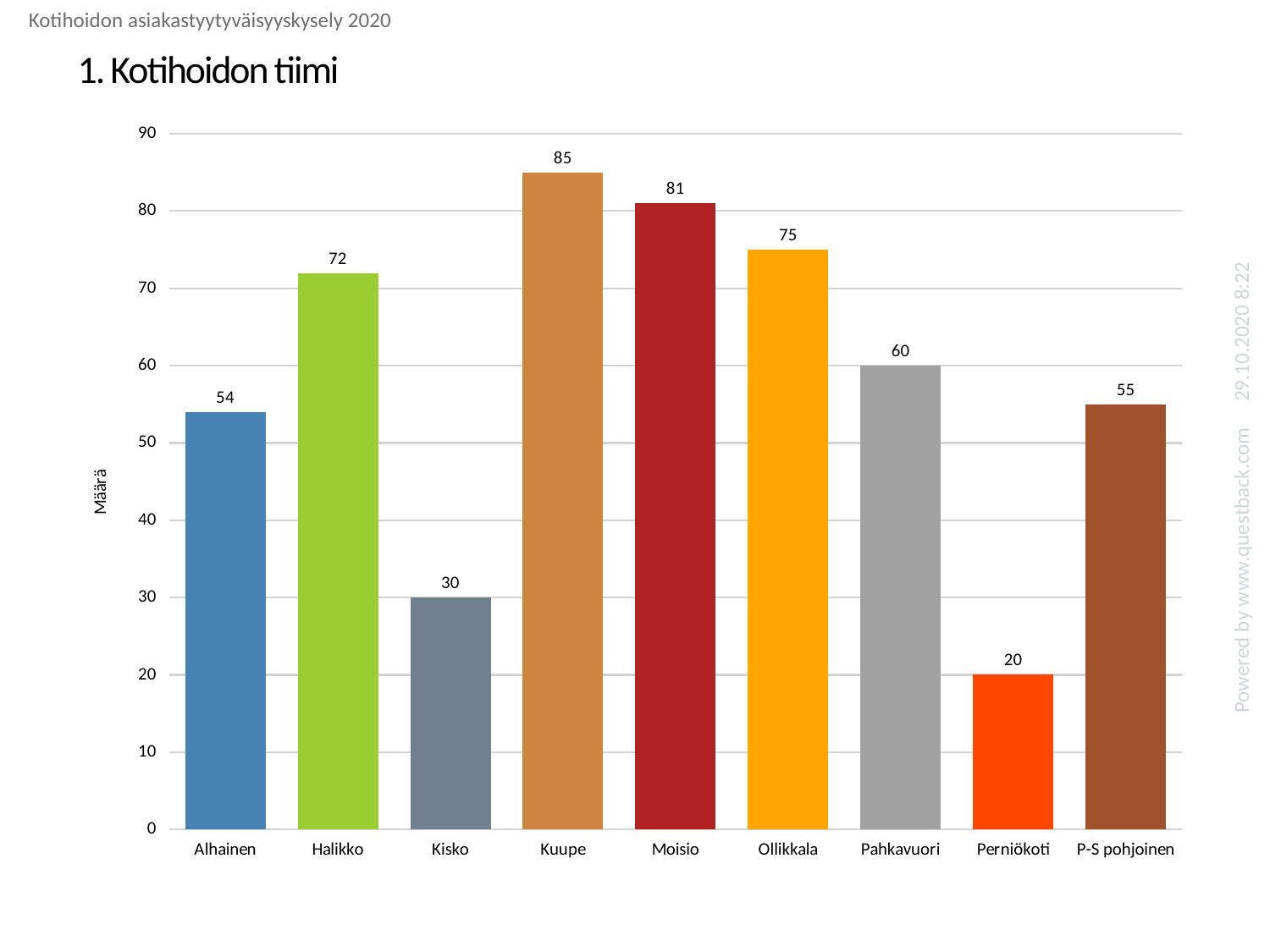
What kind of chart is shown on the slide? bar chart What is the difference between the values for Moisio and Halikko? 9 What is the value for P-S pohjoinen? 55 Is the value for Kisko greater or less than 40? less What is the title of the chart? 1. Kotihoidon tiimi What is the value for Kuupe? 85 Which category has the highest value? Kuupe What is the value for Perniökoti? 20 Which category has the lowest value? Perniökoti What is the label of the y axis? Määrä Which is larger, the value for Ollikkala or the value for Pahkavuori? Ollikkala How many categories are shown on the x axis? 9